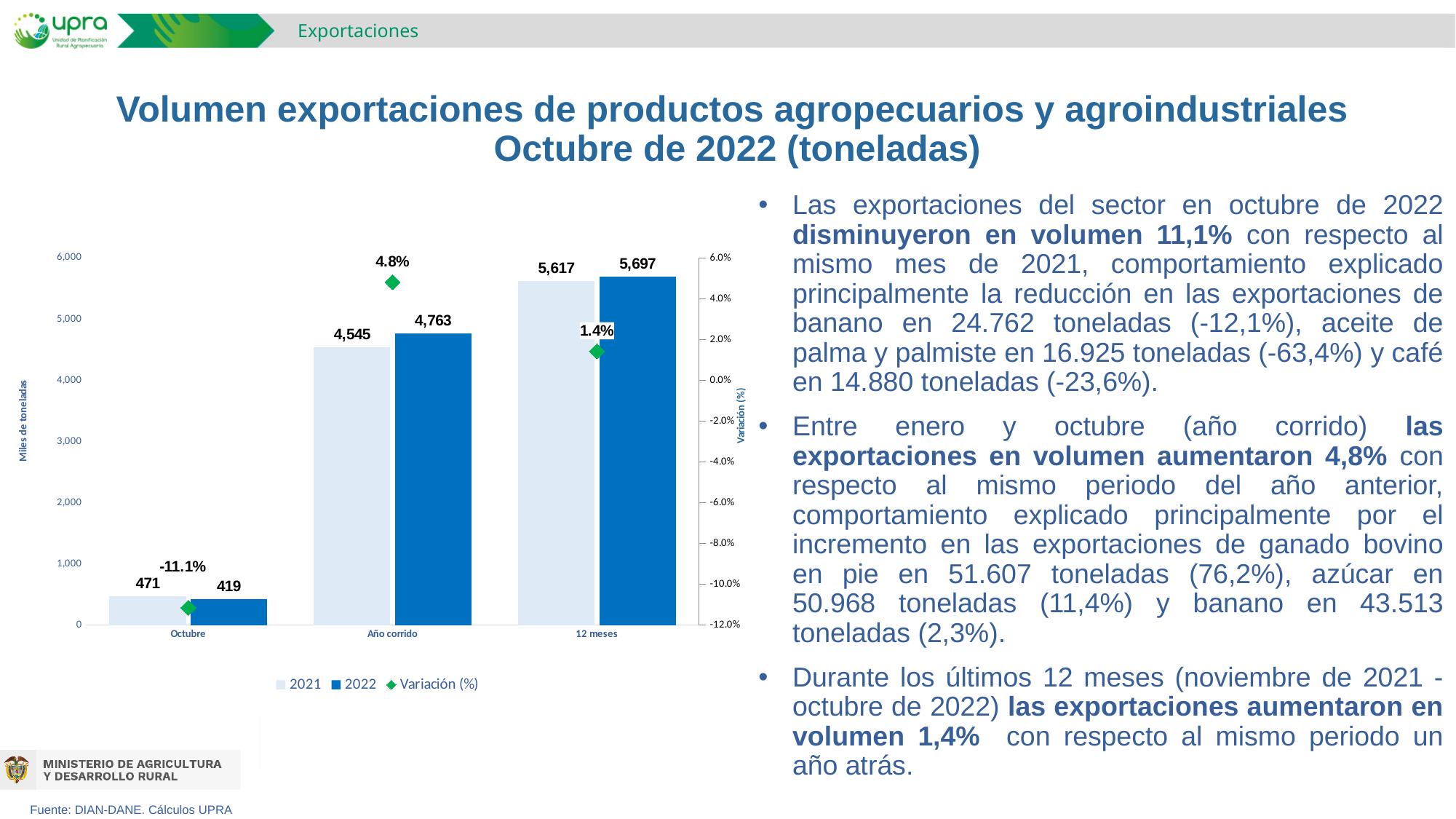
What is the label of the left vertical axis? Miles de toneladas Which category has the highest 2022 value? 12 meses What is the Variación (%) value for Octubre? -11.1% Is the 2021 value for Octubre greater or less than 1,000? less How many categories are shown on the x axis? 3 What is the 2022 value for Octubre? 419 How many series does the legend list? 3 Which is larger for 12 meses, the 2021 value or the 2022 value? 2022 What is the Variación (%) value for 12 meses? 1.4% What is the 2021 value for Año corrido? 4,545 Which category has the lowest 2021 value? Octubre What is the difference between the 2022 and 2021 values for Año corrido? 218